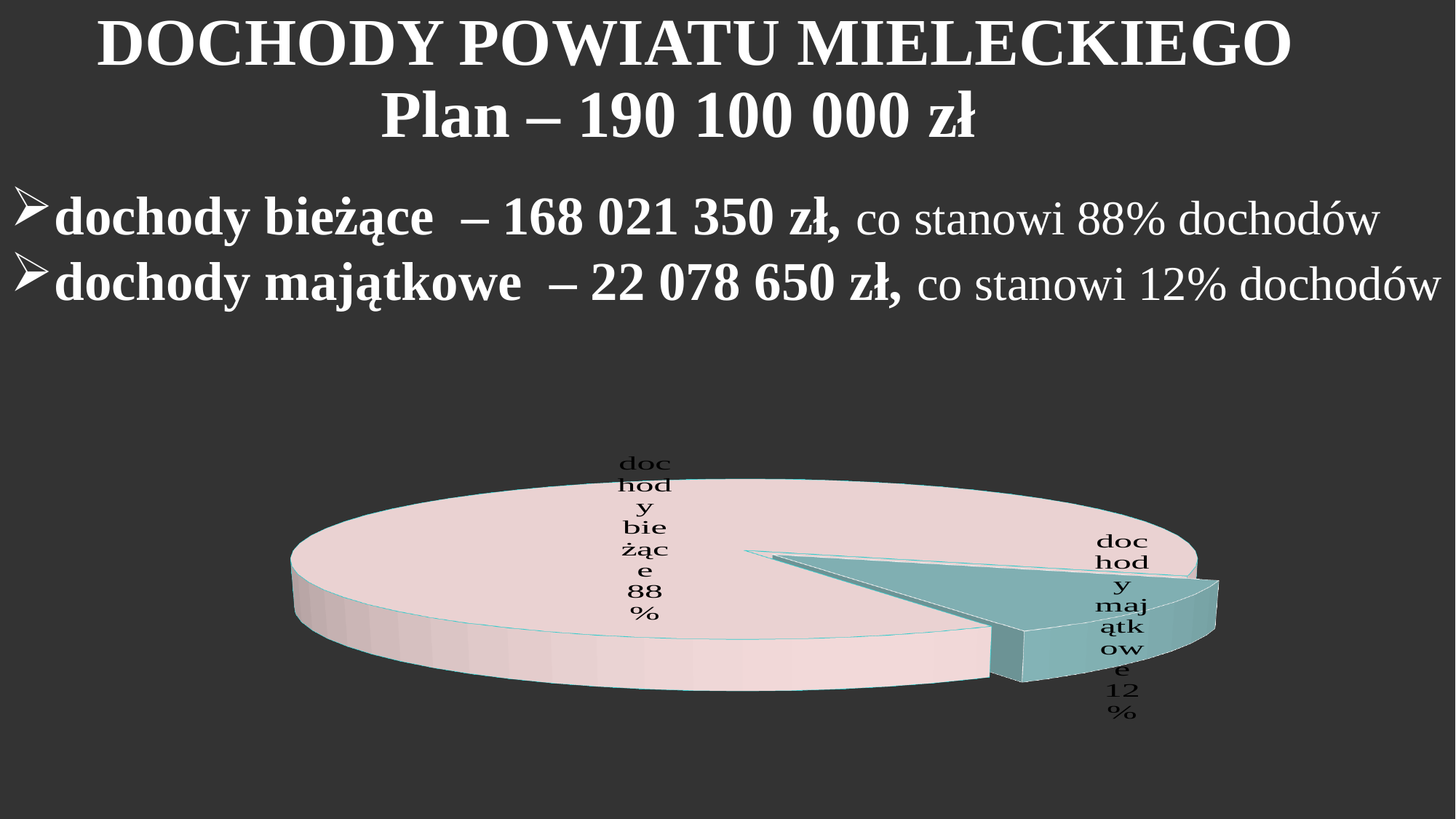
What share of the pie does the slice labelled "dochody majątkowe" represent? 12% Which slice of the pie chart is the largest? dochody bieżące What is the difference in percentage points between the dochody bieżące slice and the dochody majątkowe slice? 76 What kind of chart is shown on the slide? pie chart What share of the pie does the slice labelled "dochody bieżące" represent? 88% Which is larger in the pie chart: dochody bieżące or dochody majątkowe? dochody bieżące How many slices does the pie chart have? 2 What colour is the slice labelled "dochody majątkowe" in the pie chart? teal (blue-green) Which slice of the pie chart is the smallest? dochody majątkowe What is the total of the two slice percentages shown in the pie chart? 100% Which slice is pulled out (exploded) from the pie chart? dochody majątkowe Is the share of the dochody majątkowe slice greater or less than 50%? less